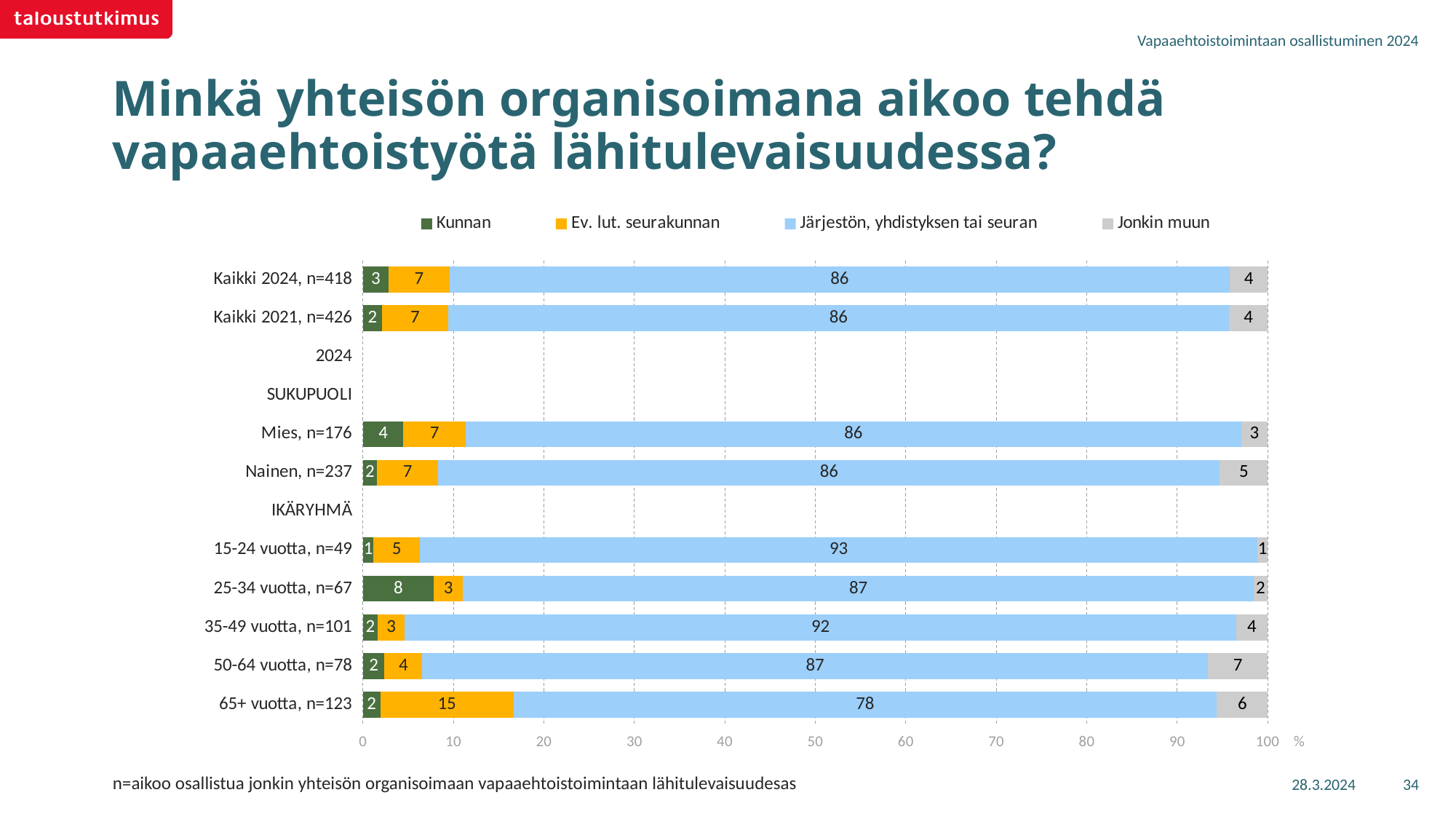
What is the difference between the 'Ev. lut. seurakunnan' values for '65+ vuotta, n=123' and '50-64 vuotta, n=78'? 11 How many categories have bars plotted in the chart? 9 What is the total of the stacked bar for 'Kaikki 2024, n=418'? 100 What is the value for 'Ev. lut. seurakunnan' in the '65+ vuotta, n=123' bar? 15 How many series does the legend list? 4 Which is larger: the 'Kunnan' value for 'Mies, n=176' or for 'Nainen, n=237'? Mies, n=176 What is the value for 'Kunnan' in the '25-34 vuotta, n=67' bar? 8 What is the value for 'Järjestön, yhdistyksen tai seuran' in the 'Kaikki 2024, n=418' bar? 86 What kind of chart is shown on the slide? Stacked bar chart Which category has the highest value for 'Järjestön, yhdistyksen tai seuran'? 15-24 vuotta, n=49 Which category has the lowest value for 'Järjestön, yhdistyksen tai seuran'? 65+ vuotta, n=123 What is the value for 'Jonkin muun' in the '50-64 vuotta, n=78' bar? 7